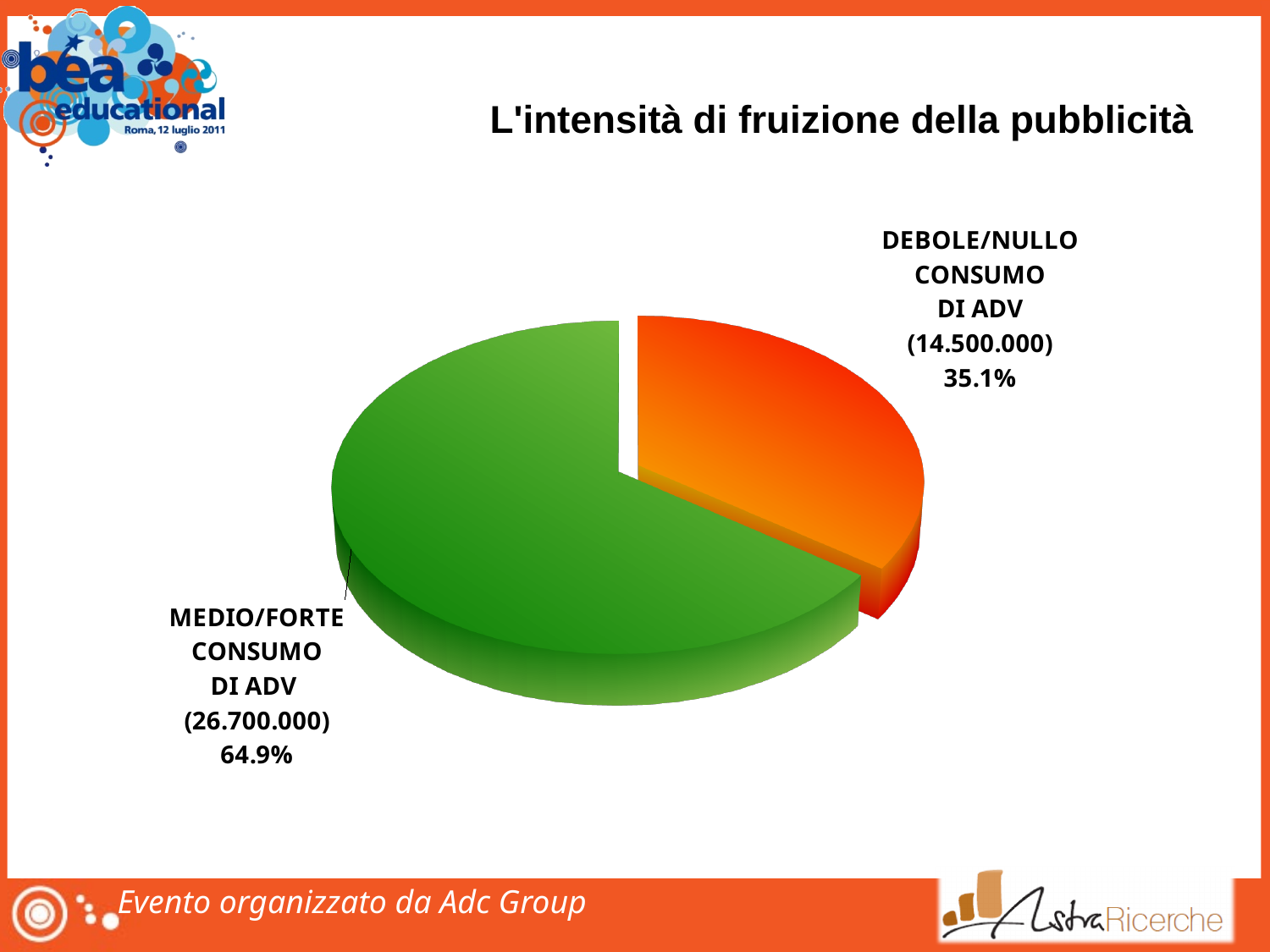
What is the difference in percentage points between the MEDIO/FORTE and DEBOLE/NULLO slices? 29.8 What percentage share does the MEDIO/FORTE CONSUMO DI ADV slice have? 64.9% Which is larger, the DEBOLE/NULLO CONSUMO DI ADV slice or the MEDIO/FORTE CONSUMO DI ADV slice? MEDIO/FORTE CONSUMO DI ADV What value is shown in parentheses for MEDIO/FORTE CONSUMO DI ADV? 26.700.000 Which slice of the pie is the smallest? DEBOLE/NULLO CONSUMO DI ADV What value is shown in parentheses for DEBOLE/NULLO CONSUMO DI ADV? 14.500.000 What percentage share does the DEBOLE/NULLO CONSUMO DI ADV slice have? 35.1% What kind of chart is shown on the slide? pie chart How many slices does the pie chart have? 2 What colour is the DEBOLE/NULLO CONSUMO DI ADV slice? orange What is the title of the chart? L'intensità di fruizione della pubblicità Which slice of the pie is the largest? MEDIO/FORTE CONSUMO DI ADV